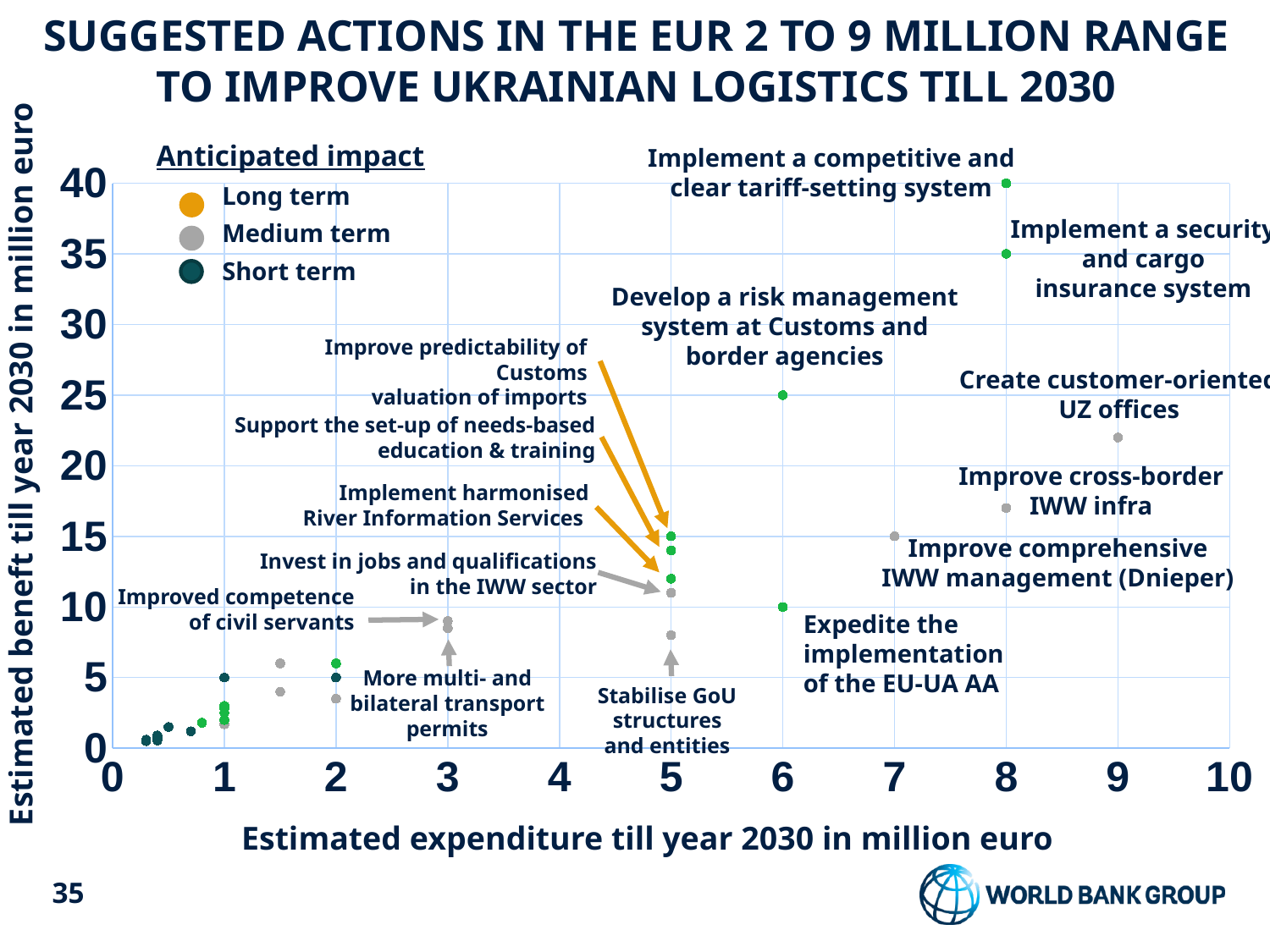
What is the title of the horizontal axis? Estimated expenditure till year 2030 in million euro What is the estimated benefit till year 2030 for 'Develop a risk management system at Customs and border agencies'? 25 Which action has the highest estimated benefit till year 2030? Implement a competitive and clear tariff-setting system What is the estimated expenditure till year 2030 for 'Develop a risk management system at Customs and border agencies'? 6 What kind of chart is shown on the slide? Scatter chart Which has the higher estimated benefit: 'Implement a competitive and clear tariff-setting system' or 'Implement a security and cargo insurance system'? Implement a competitive and clear tariff-setting system Is the estimated benefit for 'Stabilise GoU structures and entities' greater or less than 10? less Is the estimated benefit for 'Improve cross-border IWW infra' greater or less than 20? less How many categories does the 'Anticipated impact' legend list? 3 Is the estimated benefit for 'Create customer-oriented UZ offices' greater or less than 20? greater Which legend entry is shown in orange? Long term What is the estimated benefit till year 2030 for 'Implement a competitive and clear tariff-setting system'? 40